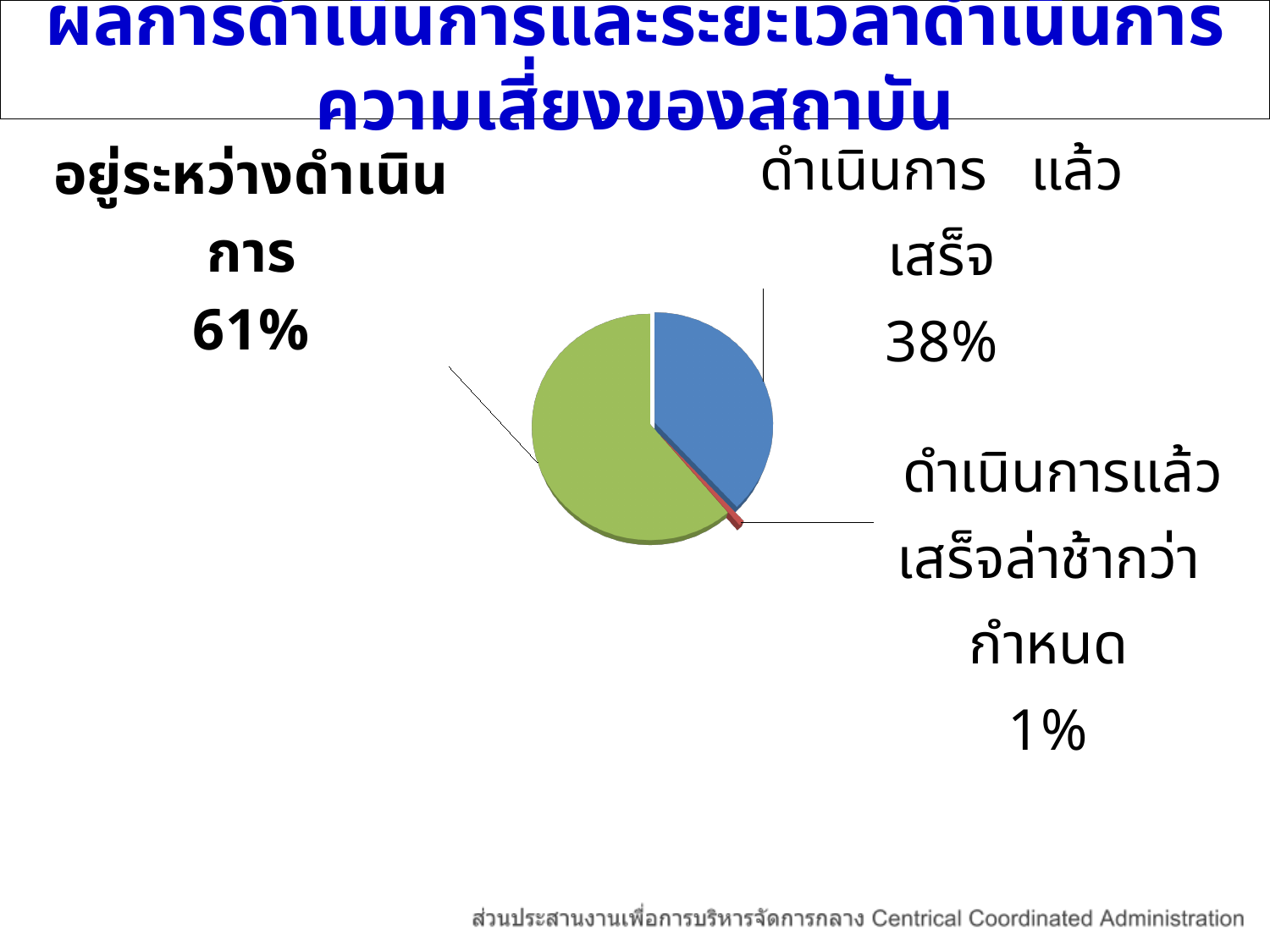
What share of the pie is labelled ดำเนินการแล้วเสร็จ? 38% What kind of chart is shown on the slide? Pie chart How many slices does the pie chart have? 3 What colour is the slice for ดำเนินการแล้วเสร็จ? Blue What colour is the slice for อยู่ระหว่างดำเนินการ? Green Which category has the smallest slice of the pie? ดำเนินการแล้วเสร็จล่าช้ากว่ากำหนด What share of the pie is labelled อยู่ระหว่างดำเนินการ? 61% What share of the pie is labelled ดำเนินการแล้วเสร็จล่าช้ากว่ากำหนด? 1% What is the difference in percentage points between อยู่ระหว่างดำเนินการ and ดำเนินการแล้วเสร็จ? 23% What is the difference in percentage points between ดำเนินการแล้วเสร็จ and ดำเนินการแล้วเสร็จล่าช้ากว่ากำหนด? 37% Which category has the largest slice of the pie? อยู่ระหว่างดำเนินการ Which is larger, the share for ดำเนินการแล้วเสร็จ or the share for ดำเนินการแล้วเสร็จล่าช้ากว่ากำหนด? ดำเนินการแล้วเสร็จ